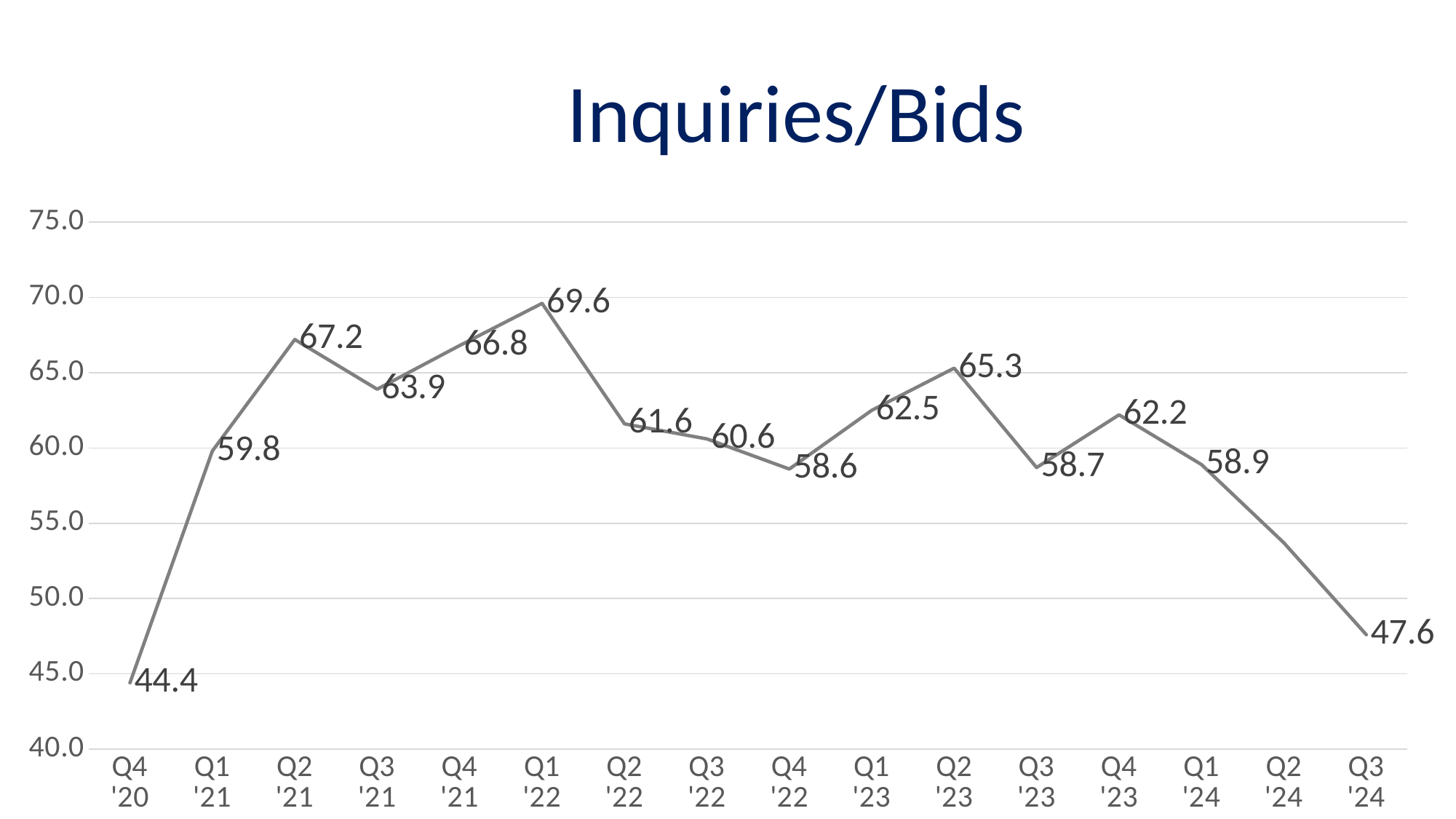
What kind of chart is shown on the slide? line chart What is the value for Q4 '20? 44.4 Which is larger, the value for Q2 '23 or the value for Q4 '23? Q2 '23 What is the value for Q1 '22? 69.6 What is the title of the chart? Inquiries/Bids How many quarters are plotted on the x axis? 16 Which quarter has the highest value? Q1 '22 Is the value for Q2 '24 greater or less than 55.0? less What is the difference between the values for Q1 '22 and Q4 '20? 25.2 What is the value for Q3 '24? 47.6 What is the difference between the values for Q1 '24 and Q3 '24? 11.3 Which quarter has the lowest value? Q4 '20